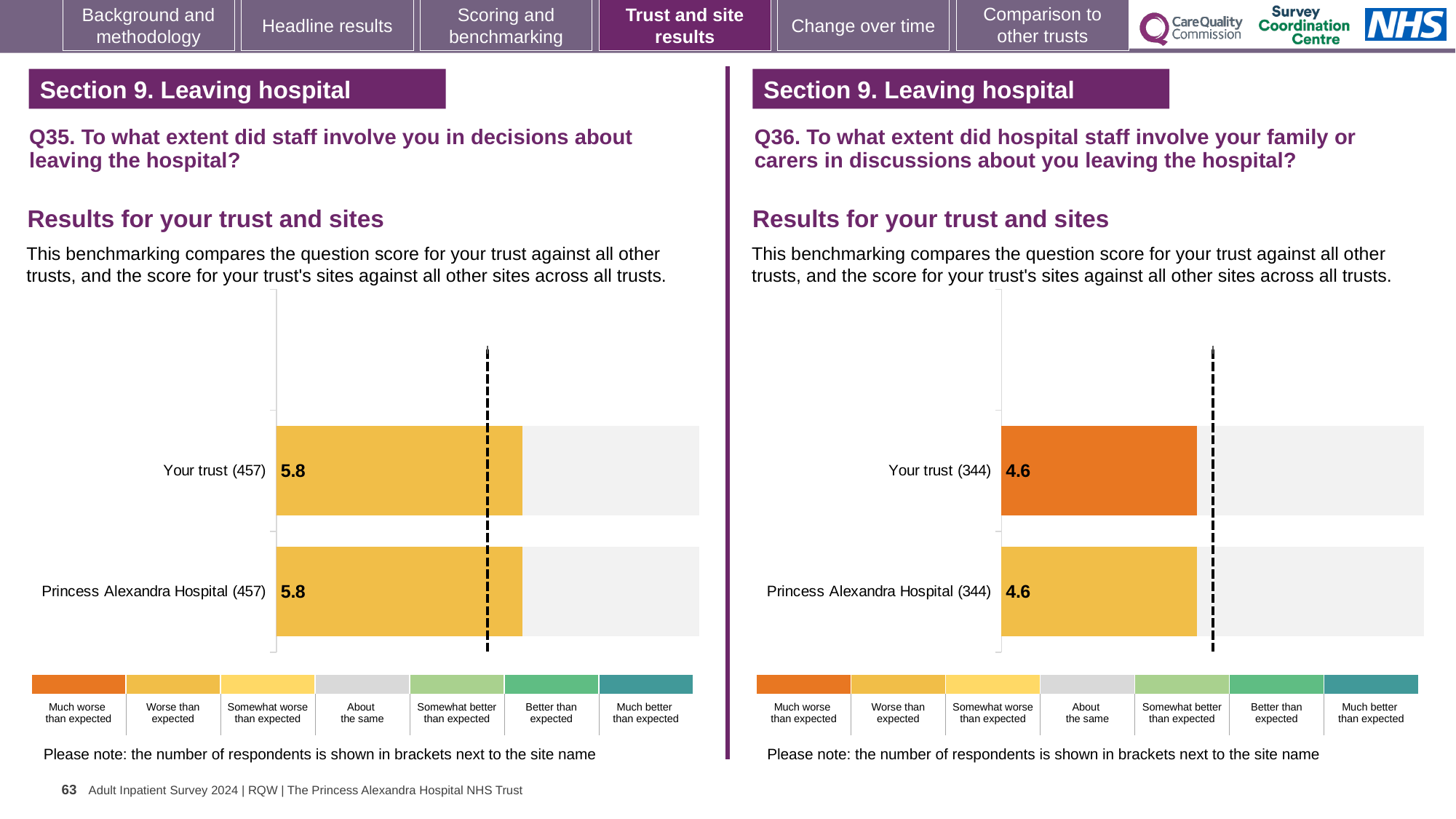
On the Q35 chart (left), what is the score for Your trust? 5.8 On the Q36 chart (right), which benchmark category does the colour of the Your trust bar correspond to? Much worse than expected On the Q35 chart (left), what is the difference between the score for Your trust and the score for Princess Alexandra Hospital? 0 What kind of chart is used on the Q35 chart (left)? Bar chart On the Q36 chart (right), how many respondents are shown in brackets for Princess Alexandra Hospital? 344 On the Q35 chart (left), which benchmark category does the colour of the Princess Alexandra Hospital bar correspond to? Worse than expected On the Q36 chart (right), what is the score for Princess Alexandra Hospital? 4.6 On the Q35 chart (left), how many respondents are shown in brackets for Your trust? 457 On the Q36 chart (right), how many bars are plotted? 2 On the Q35 chart (left), what is the score for Princess Alexandra Hospital? 5.8 Is the score for Your trust on the Q35 chart (left) larger or smaller than the score for Your trust on the Q36 chart (right)? Larger On the Q36 chart (right), what is the score for Your trust? 4.6